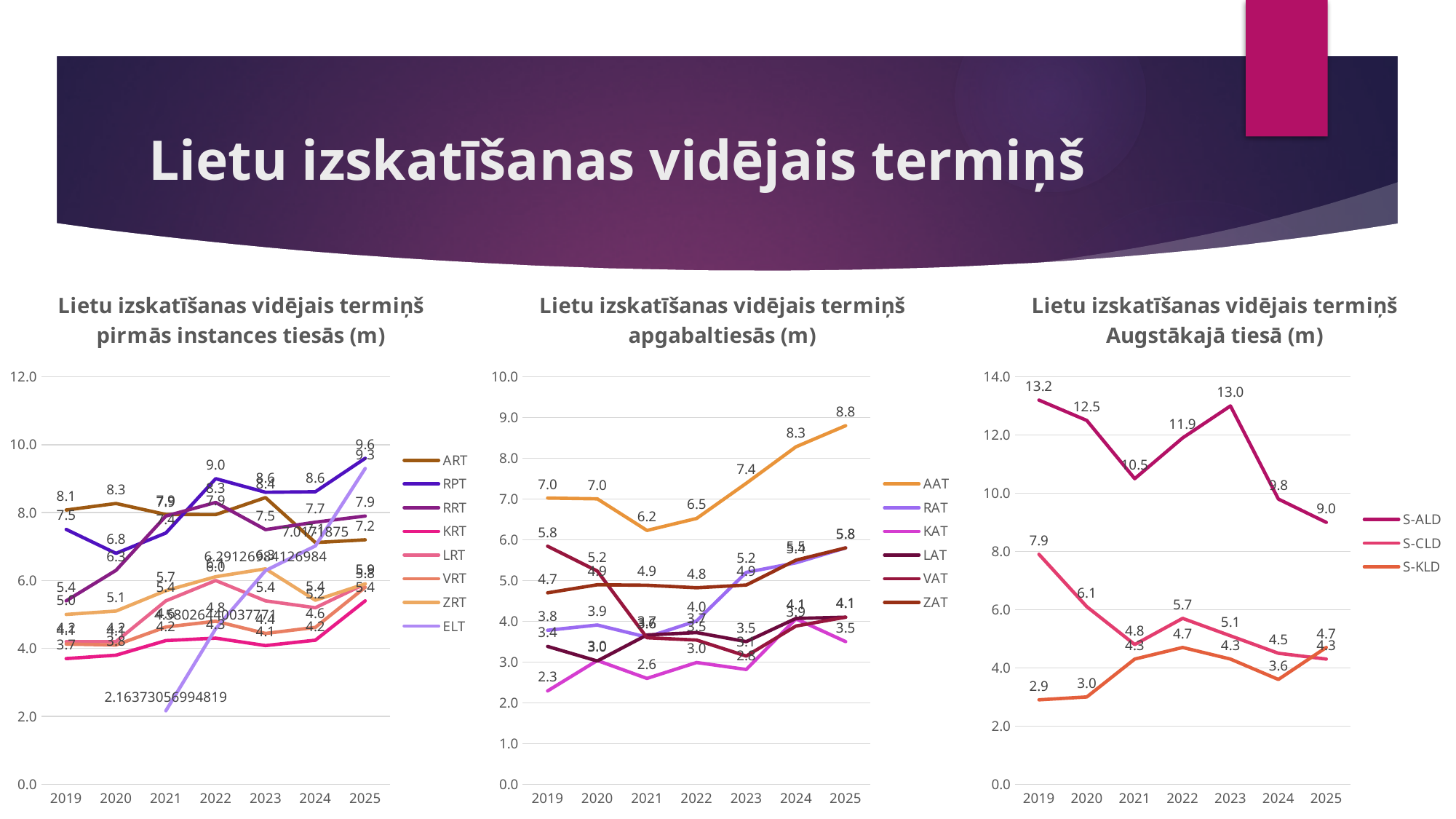
In the chart titled 'Lietu izskatīšanas vidējais termiņš apgabaltiesās (m)', what is the value for KAT in 2019? 2.3 What kind of chart is the chart titled 'Lietu izskatīšanas vidējais termiņš pirmās instances tiesās (m)'? line chart In the chart titled 'Lietu izskatīšanas vidējais termiņš pirmās instances tiesās (m)', how many series does the legend list? 8 In the chart titled 'Lietu izskatīšanas vidējais termiņš apgabaltiesās (m)', how many years are shown on the x axis? 7 In the chart titled 'Lietu izskatīšanas vidējais termiņš apgabaltiesās (m)', which series has the highest value in 2023? AAT In the chart titled 'Lietu izskatīšanas vidējais termiņš Augstākajā tiesā (m)', what is the value for S-ALD in 2019? 13.2 In the chart titled 'Lietu izskatīšanas vidējais termiņš Augstākajā tiesā (m)', what is the value for S-KLD in 2022? 4.7 In the chart titled 'Lietu izskatīšanas vidējais termiņš Augstākajā tiesā (m)', in which year is the S-ALD value lowest? 2025 In the chart titled 'Lietu izskatīšanas vidējais termiņš apgabaltiesās (m)', what is the value for AAT in 2025? 8.8 In the chart titled 'Lietu izskatīšanas vidējais termiņš apgabaltiesās (m)', is the AAT value in 2021 greater or less than 7.0? less In the chart titled 'Lietu izskatīšanas vidējais termiņš Augstākajā tiesā (m)', how many series does the legend list? 3 In the chart titled 'Lietu izskatīšanas vidējais termiņš Augstākajā tiesā (m)', what is the difference between the S-ALD values in 2019 and 2025? 4.2